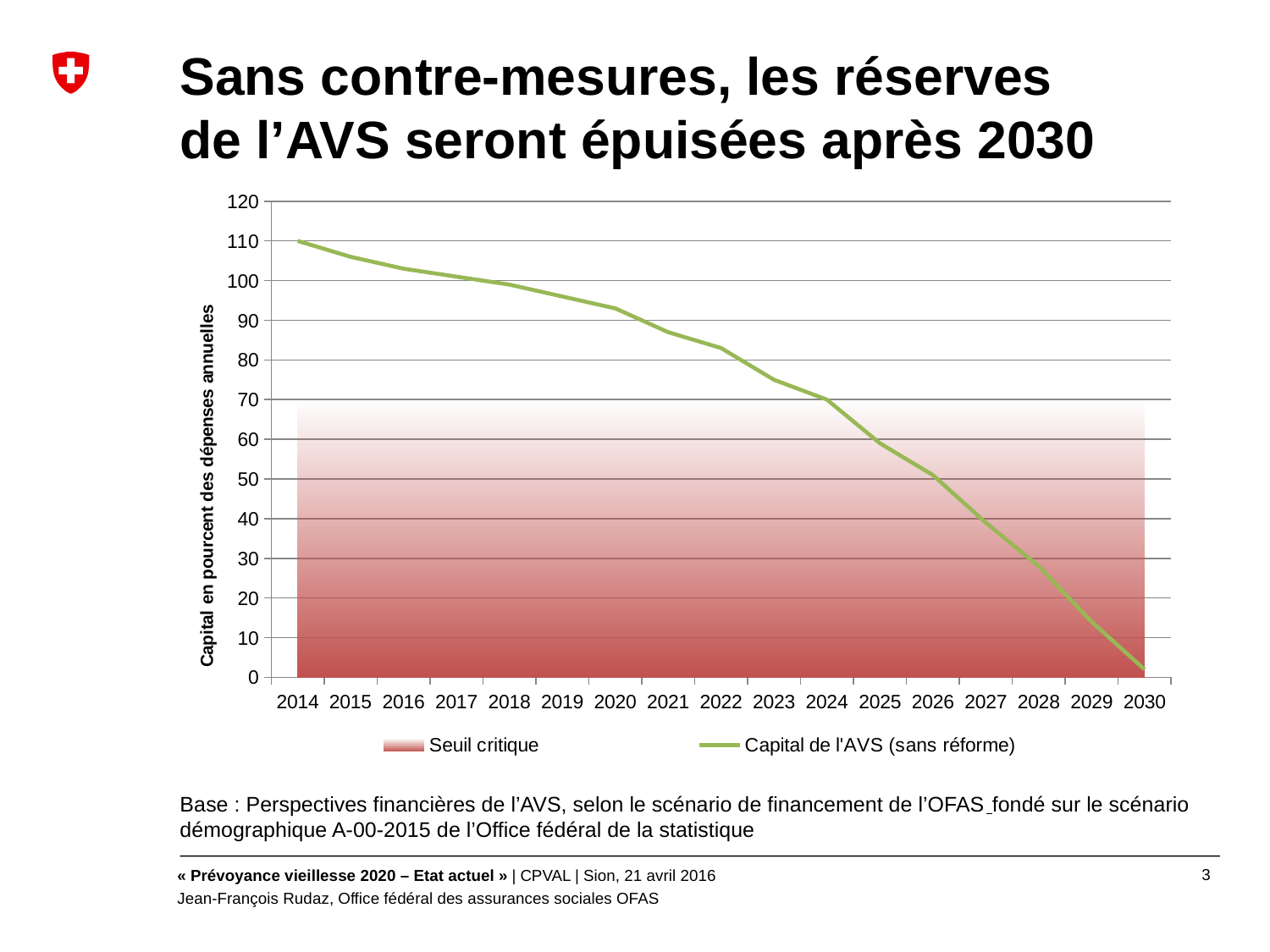
How many years are shown along the x axis? 17 Does the 'Capital de l'AVS (sans réforme)' line rise or fall from 2014 to 2030? fall Is the 'Capital de l'AVS (sans réforme)' value for 2028 greater or less than 40? less How many series does the legend list? 2 In which year is the 'Capital de l'AVS (sans réforme)' value highest? 2014 Is the 'Capital de l'AVS (sans réforme)' value for 2026 greater or less than 60? less In which year is the 'Capital de l'AVS (sans réforme)' value lowest? 2030 Which year has a larger 'Capital de l'AVS (sans réforme)' value, 2018 or 2025? 2018 What kind of chart is shown on the slide? line chart What is the label of the y axis? Capital en pourcent des dépenses annuelles What is the name of the shaded red area in the legend? Seuil critique Is the 'Capital de l'AVS (sans réforme)' value for 2020 greater or less than 90? greater